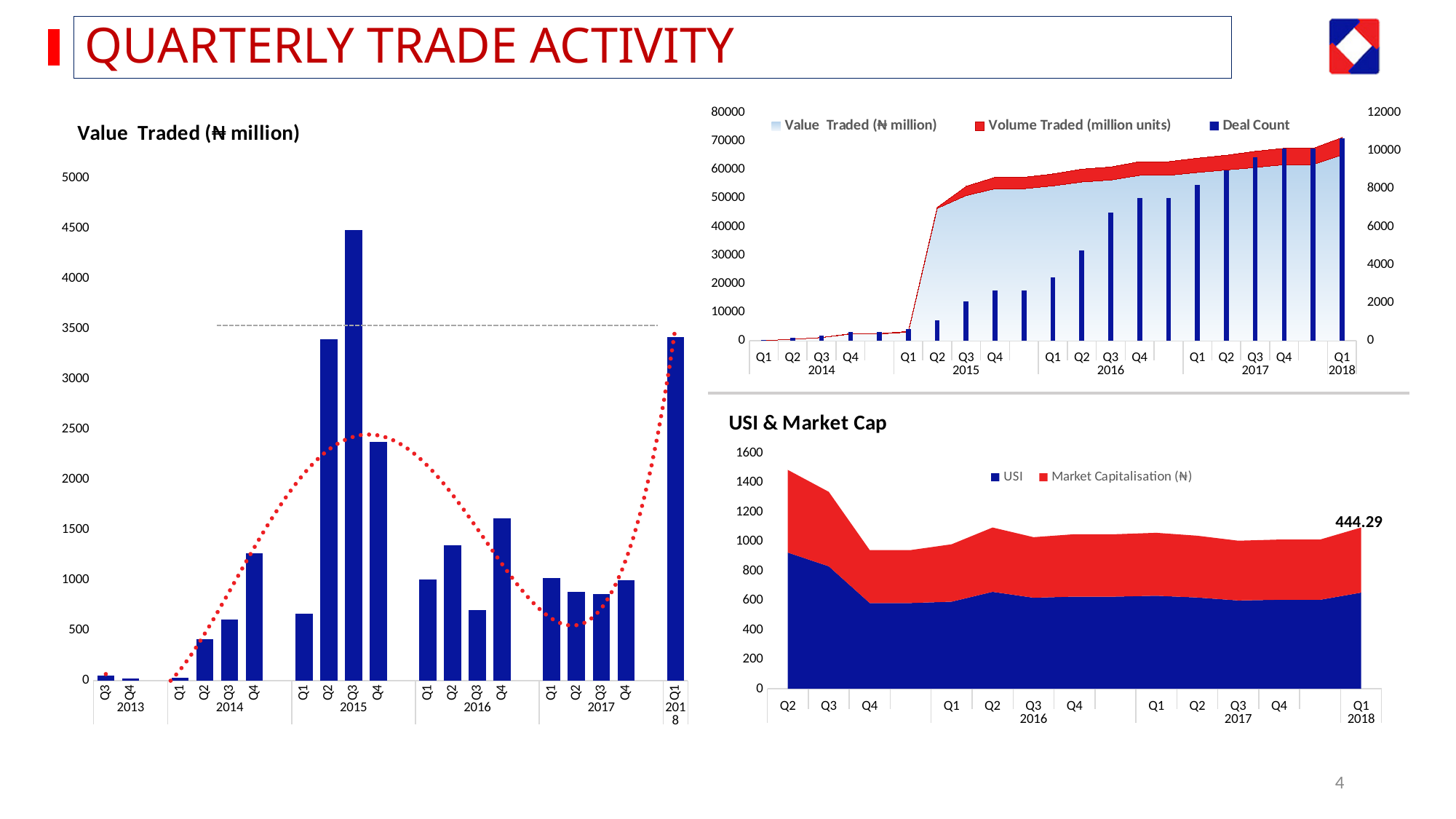
In the 'Value Traded (₦ million)' chart on the left, is the value for Q3 2015 greater or less than 4000? greater In the top-right chart, which quarter has the highest Deal Count bar? Q1 2018 In the top-right chart, is the Deal Count for Q1 2018 greater or less than 10000 on the right-hand axis? greater In the 'Value Traded (₦ million)' chart on the left, is the value for Q2 2014 greater or less than 500? less What are the two series listed in the legend of the 'USI & Market Cap' chart? USI and Market Capitalisation (₦) How many bars are plotted in the 'Value Traded (₦ million)' chart on the left? 19 In the 'Value Traded (₦ million)' chart on the left, which is larger: the value for Q4 2015 or the value for Q4 2016? Q4 2015 In the 'USI & Market Cap' chart, what value is printed as the data label at Q1 2018? 444.29 How many series does the legend of the top-right chart list? 3 In the 'Value Traded (₦ million)' chart on the left, which quarter has the highest bar? Q3 2015 What type of chart is the 'Value Traded (₦ million)' chart on the left of the slide? bar chart